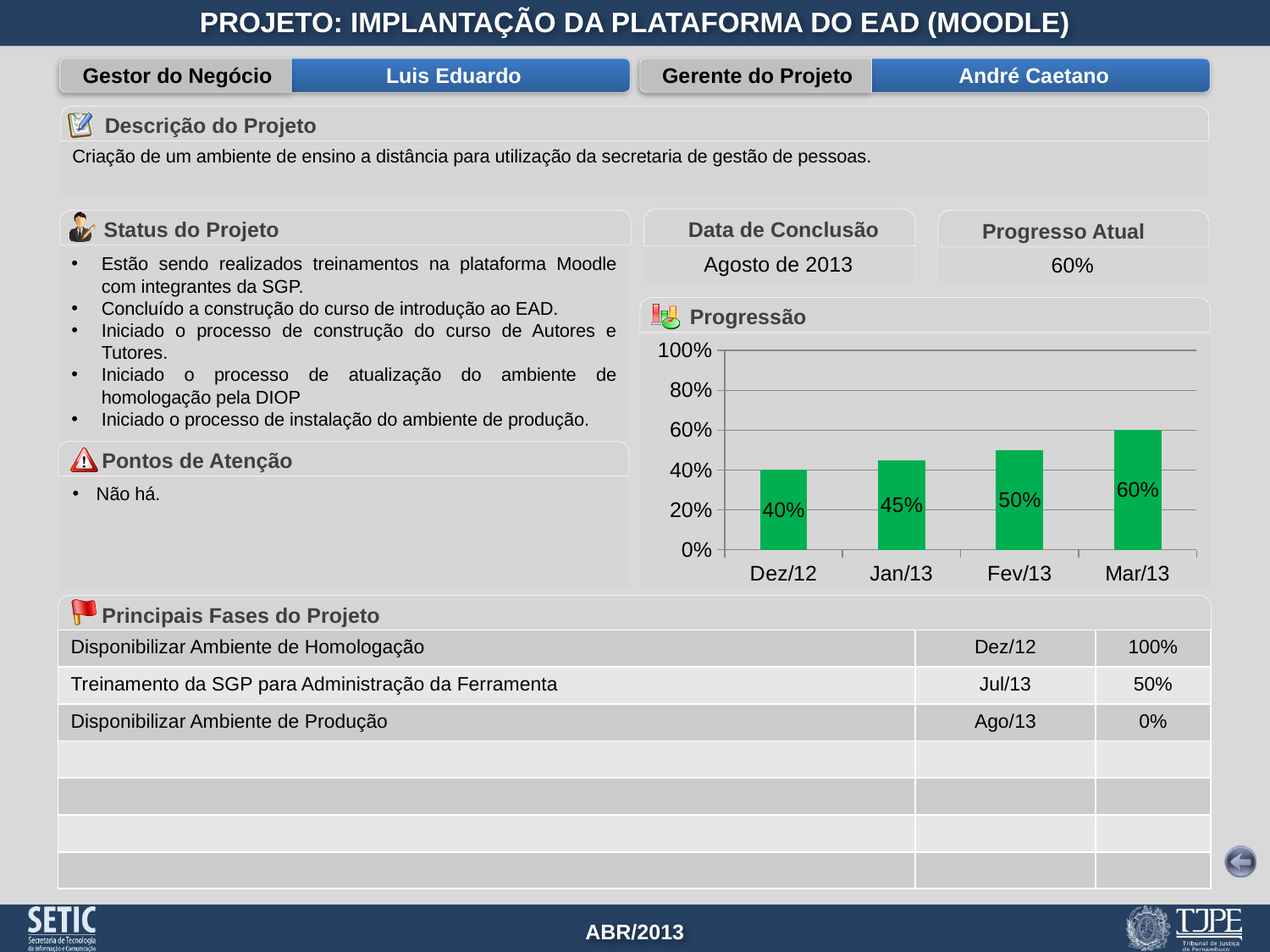
Which month has the highest value in the Progressão chart? Mar/13 What is the title of the chart on the slide? Progressão What is the value for Dez/12 in the Progressão chart? 40% What is the difference between the values for Mar/13 and Dez/12 in the Progressão chart? 20% What is the value for Fev/13 in the Progressão chart? 50% What is the value for Jan/13 in the Progressão chart? 45% How many months are shown in the Progressão chart? 4 Which is larger in the Progressão chart, the value for Jan/13 or Fev/13? Fev/13 Which month has the lowest value in the Progressão chart? Dez/12 Do the values in the Progressão chart rise or fall from Dez/12 to Mar/13? Rise What is the value for Mar/13 in the Progressão chart? 60% What kind of chart is the Progressão chart? Bar chart